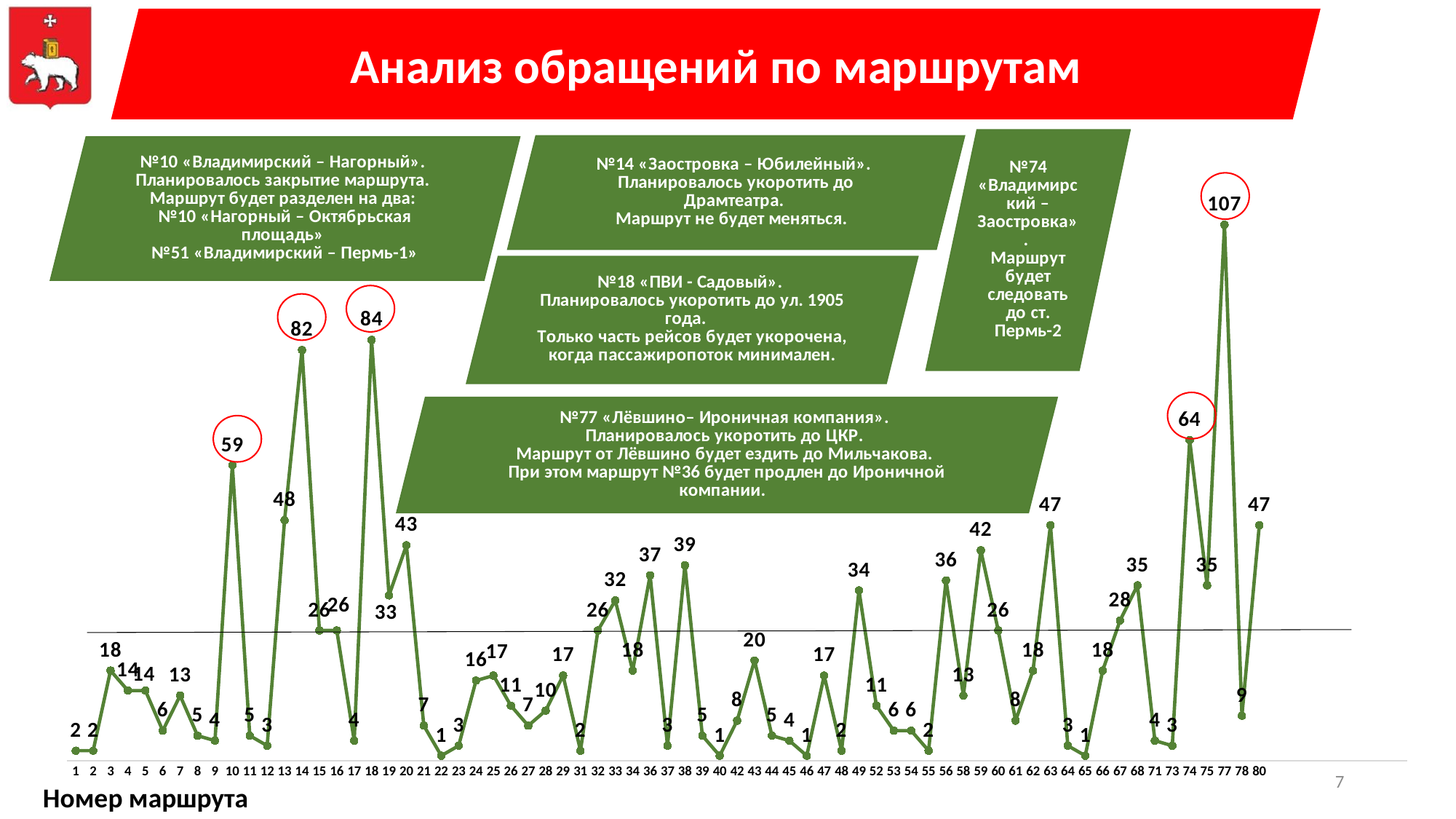
What is the value for route 77? 107 What kind of chart is shown on the slide? line chart What is the value for route 10? 59 What is the value for route 18? 84 Which route number has the highest value on the chart? 77 What is the value for route 14? 82 What is the title of the chart on the slide? Анализ обращений по маршрутам What is the difference between the values for route 77 and route 74? 43 What is the label of the x axis of the chart? Номер маршрута What is the lowest value plotted on the chart? 1 What is the value for route 74? 64 Which has the larger value, route 13 or route 20? route 13